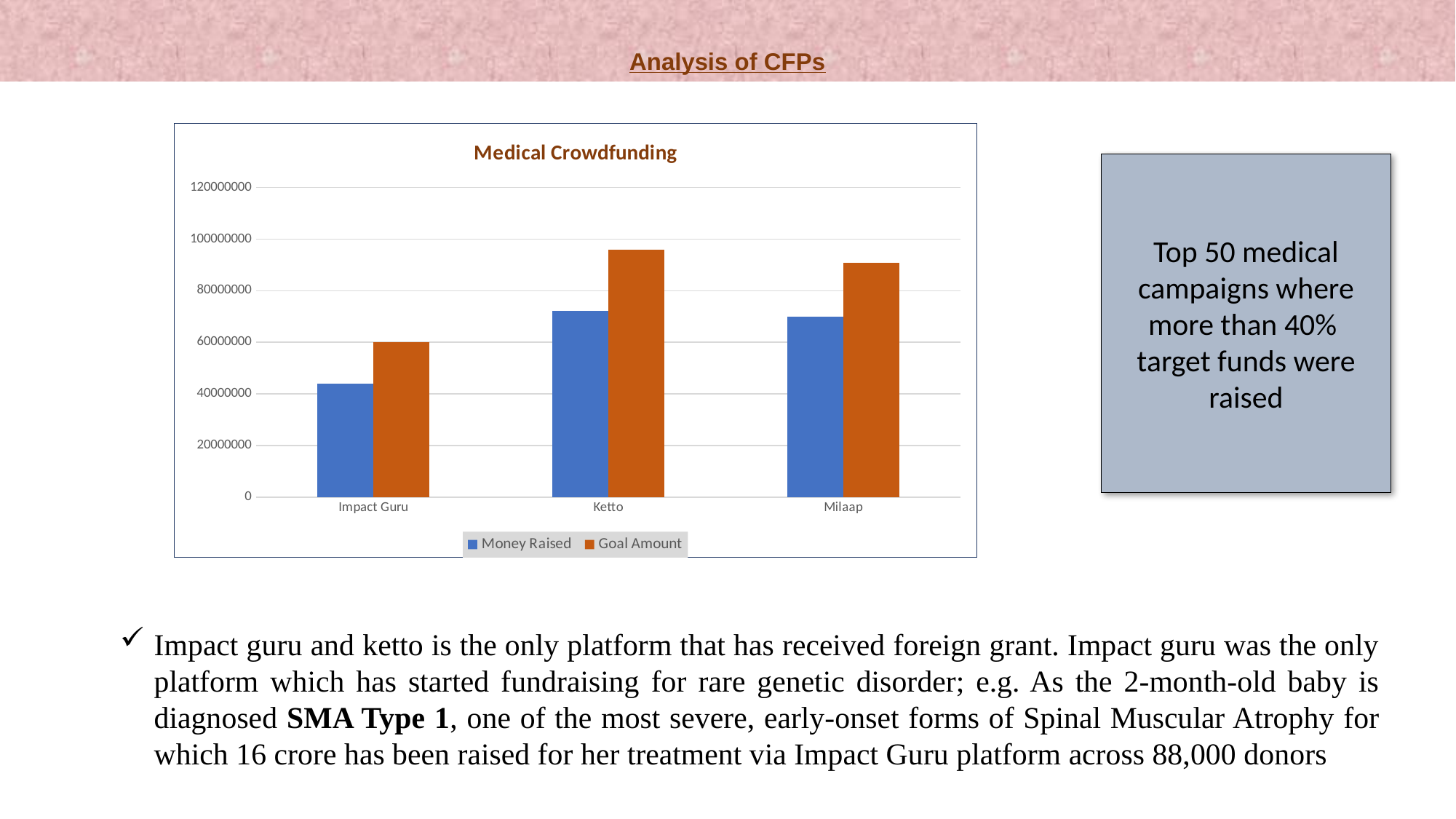
Which platform has the lowest Money Raised? Impact Guru Is the Goal Amount for Ketto greater or less than 80000000? greater Which platform has the lowest Goal Amount? Impact Guru For Milaap, which is larger: Money Raised or Goal Amount? Goal Amount What type of chart is shown on the slide? Bar chart Is the Money Raised value for Impact Guru greater or less than 60000000? less Which colour represents the Goal Amount series in the chart? Orange Is the Money Raised value for Ketto greater or less than 60000000? greater Which platform has the highest Goal Amount? Ketto How many series does the chart legend list? 2 What is the title of the chart? Medical Crowdfunding How many platforms (categories) are shown on the x axis of the chart? 3